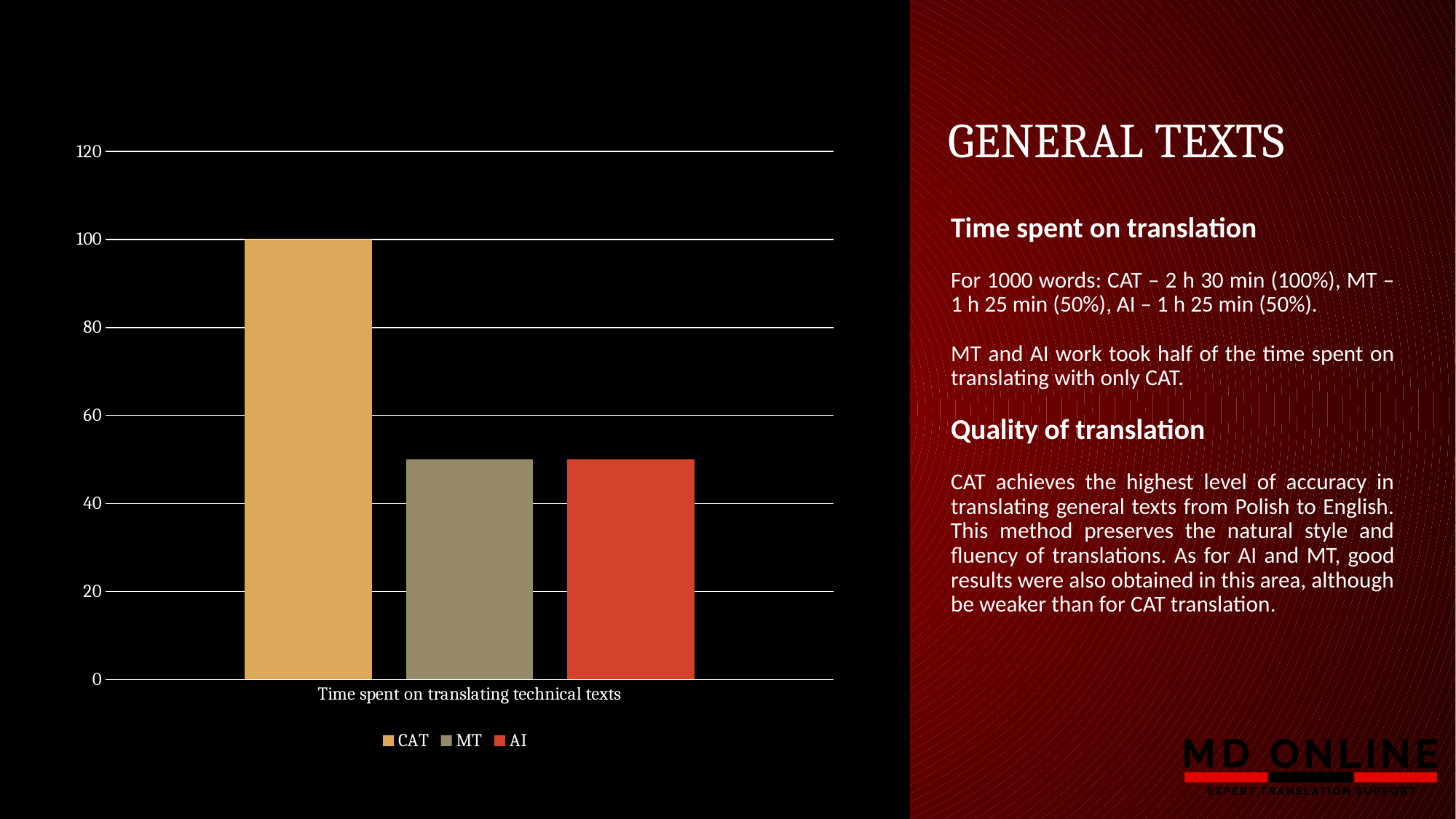
What are the series names listed in the chart legend? CAT, MT, AI Is the value for MT in the chart greater or less than 60? less Is the value for CAT in the chart greater or less than 80? greater Which is larger in the chart, the AI bar or the CAT bar? CAT Is the value for AI in the chart greater or less than 40? greater Which is larger in the chart, the CAT bar or the MT bar? CAT Which series has the highest bar in the chart? CAT How many series does the chart legend list? 3 What is the category label shown on the x axis of the chart? Time spent on translating technical texts What type of chart is shown on the slide? bar chart How many bars are plotted in the chart? 3 What is the value of the CAT bar in the chart? 100